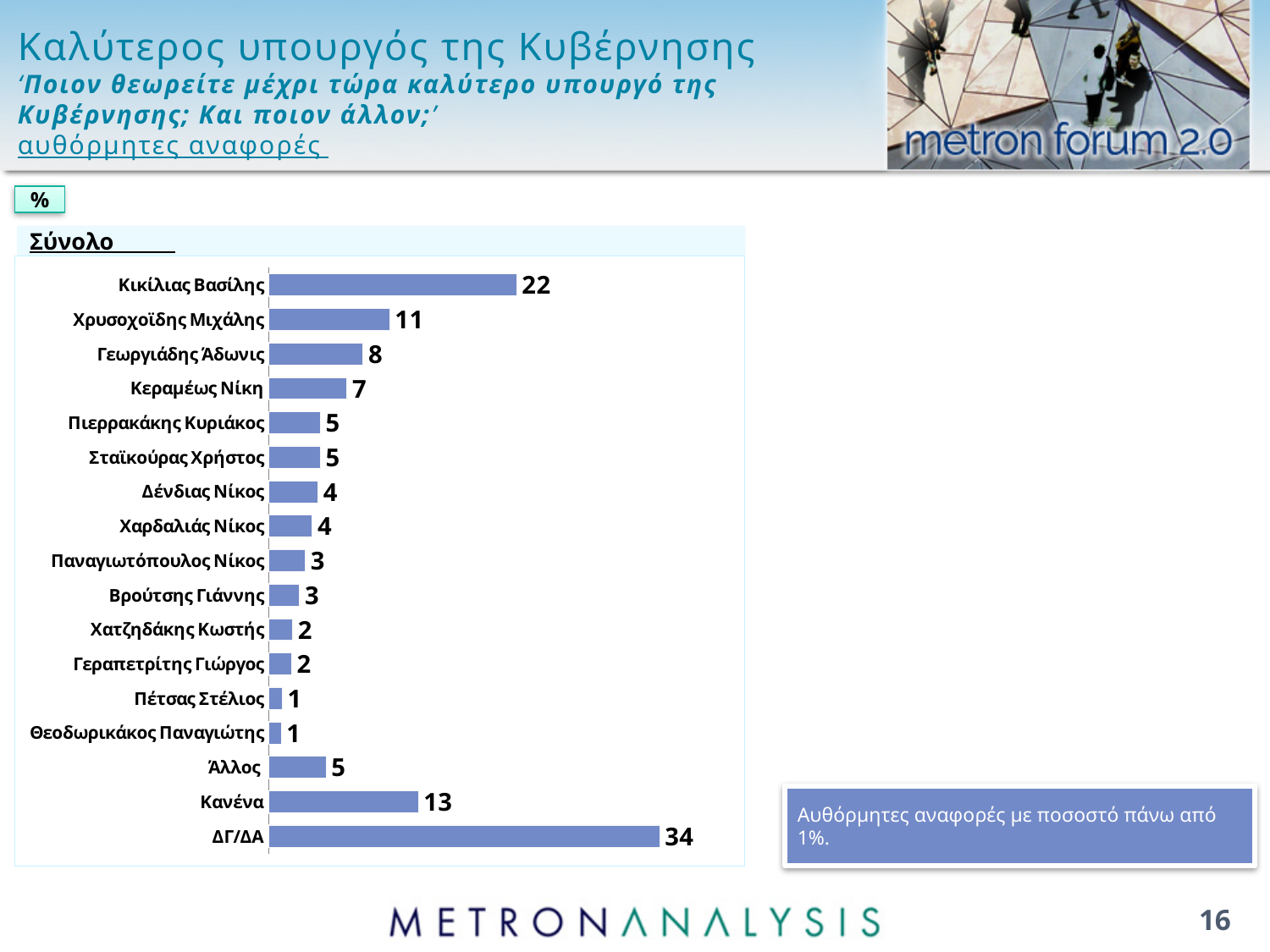
What value is shown for ΔΓ/ΔΑ? 34 What value is shown for Κεραμέως Νίκη? 7 What value is shown for Κικίλιας Βασίλης? 22 Which named minister has the highest value in the chart? Κικίλιας Βασίλης What is the difference between the values for Κικίλιας Βασίλης and Χρυσοχοΐδης Μιχάλης? 11 Which is larger, the value for Γεωργιάδης Άδωνις or the value for Κεραμέως Νίκη? Γεωργιάδης Άδωνις What value is shown for Χρυσοχοΐδης Μιχάλης? 11 Which category has the highest value in the chart? ΔΓ/ΔΑ What is the difference between the values for ΔΓ/ΔΑ and Κανένα? 21 What kind of chart is shown on the slide? Bar chart How many categories are shown in the chart? 17 What value is shown for Κανένα? 13